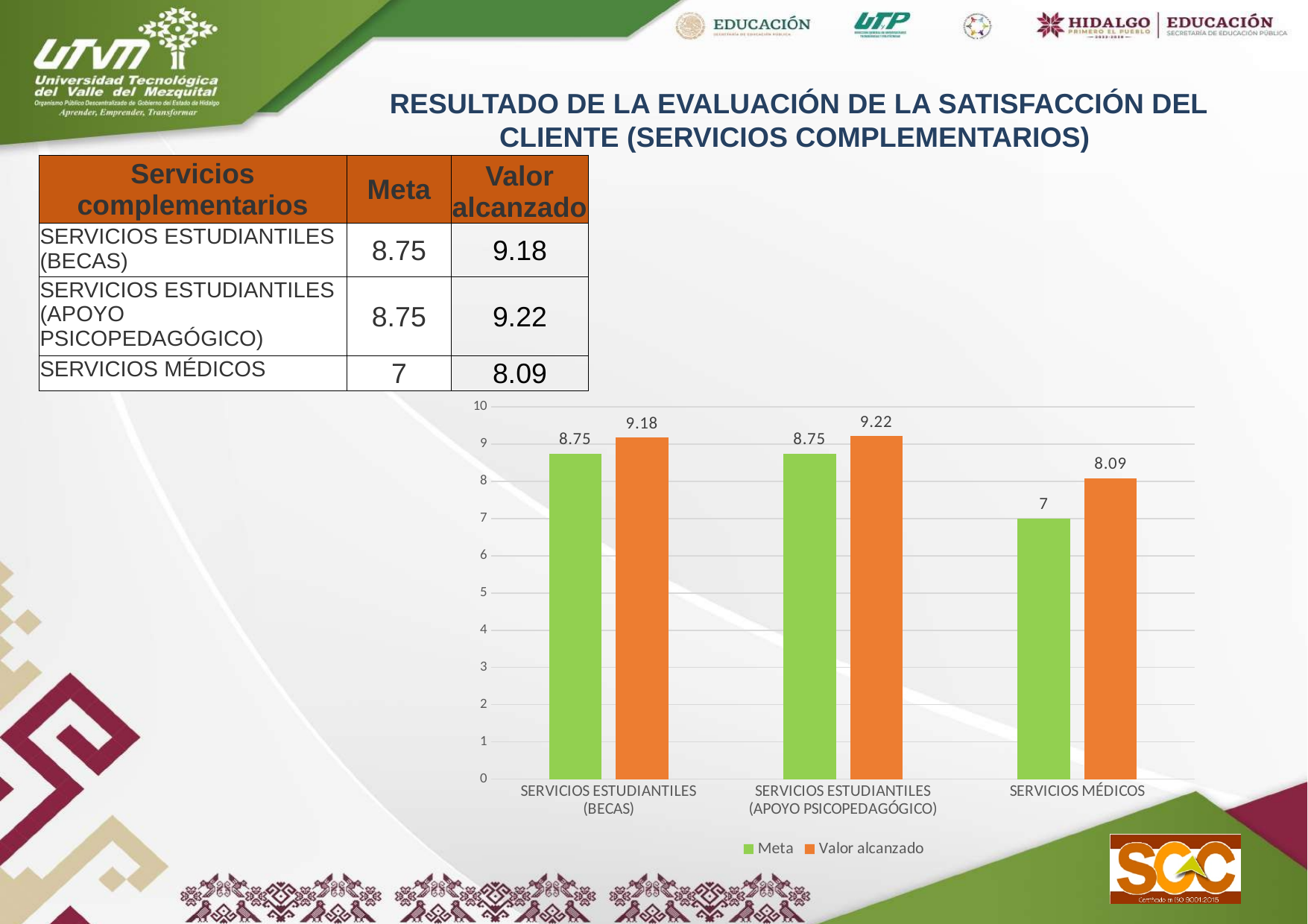
How many categories are shown on the x axis of the chart? 3 What is the Meta for SERVICIOS MÉDICOS? 7 How many series does the chart legend list? 2 Which category has the lowest Meta? SERVICIOS MÉDICOS Is the Valor alcanzado for SERVICIOS MÉDICOS greater or less than 8? greater What is the difference between the Valor alcanzado and the Meta for SERVICIOS MÉDICOS? 1.09 Which category has the highest Valor alcanzado? SERVICIOS ESTUDIANTILES (APOYO PSICOPEDAGÓGICO) What is the Valor alcanzado for SERVICIOS MÉDICOS? 8.09 Which is larger for SERVICIOS ESTUDIANTILES (BECAS): the Meta or the Valor alcanzado? Valor alcanzado What is the Valor alcanzado for SERVICIOS ESTUDIANTILES (APOYO PSICOPEDAGÓGICO)? 9.22 What kind of chart is shown on the slide? bar chart What is the Meta for SERVICIOS ESTUDIANTILES (BECAS)? 8.75